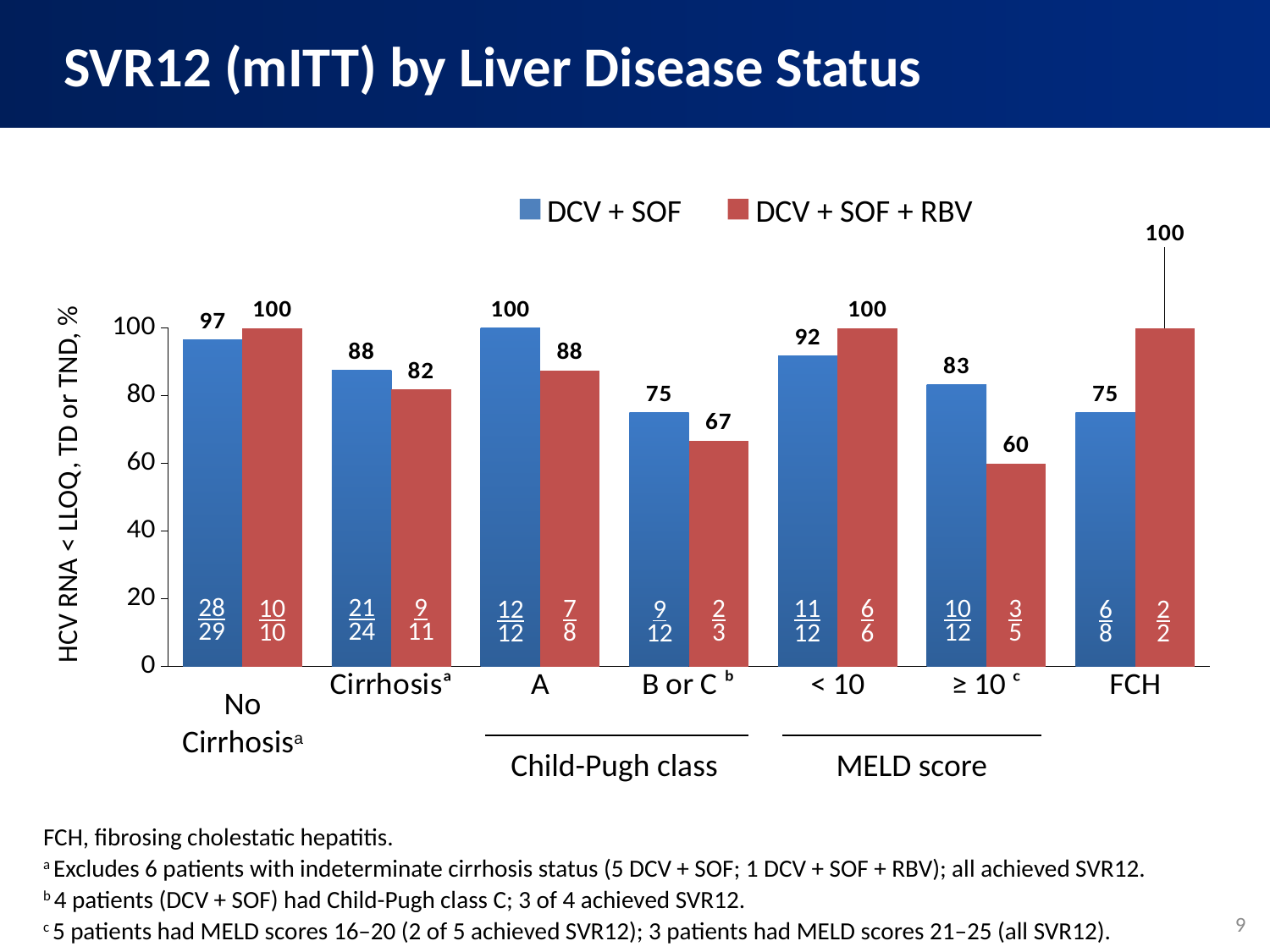
What kind of chart is shown on the slide? Bar chart How many categories are shown on the x axis of the chart? 7 What is the SVR12 value for DCV + SOF in the No Cirrhosis group? 97 What is the SVR12 value for DCV + SOF + RBV in the Cirrhosis group? 82 How many series does the legend list? 2 Which category has the lowest SVR12 value for DCV + SOF + RBV? ≥ 10 What is the SVR12 value for DCV + SOF + RBV in the Child-Pugh class B or C group? 67 Which category has the lowest SVR12 value for DCV + SOF? B or C and FCH (both 75) In the FCH group, which series has the higher SVR12 value? DCV + SOF + RBV What is the difference between the DCV + SOF and DCV + SOF + RBV values in the MELD score ≥ 10 group? 23 What is the SVR12 value for DCV + SOF in the MELD score ≥ 10 group? 83 In the Cirrhosis group, which series has the higher SVR12 value? DCV + SOF